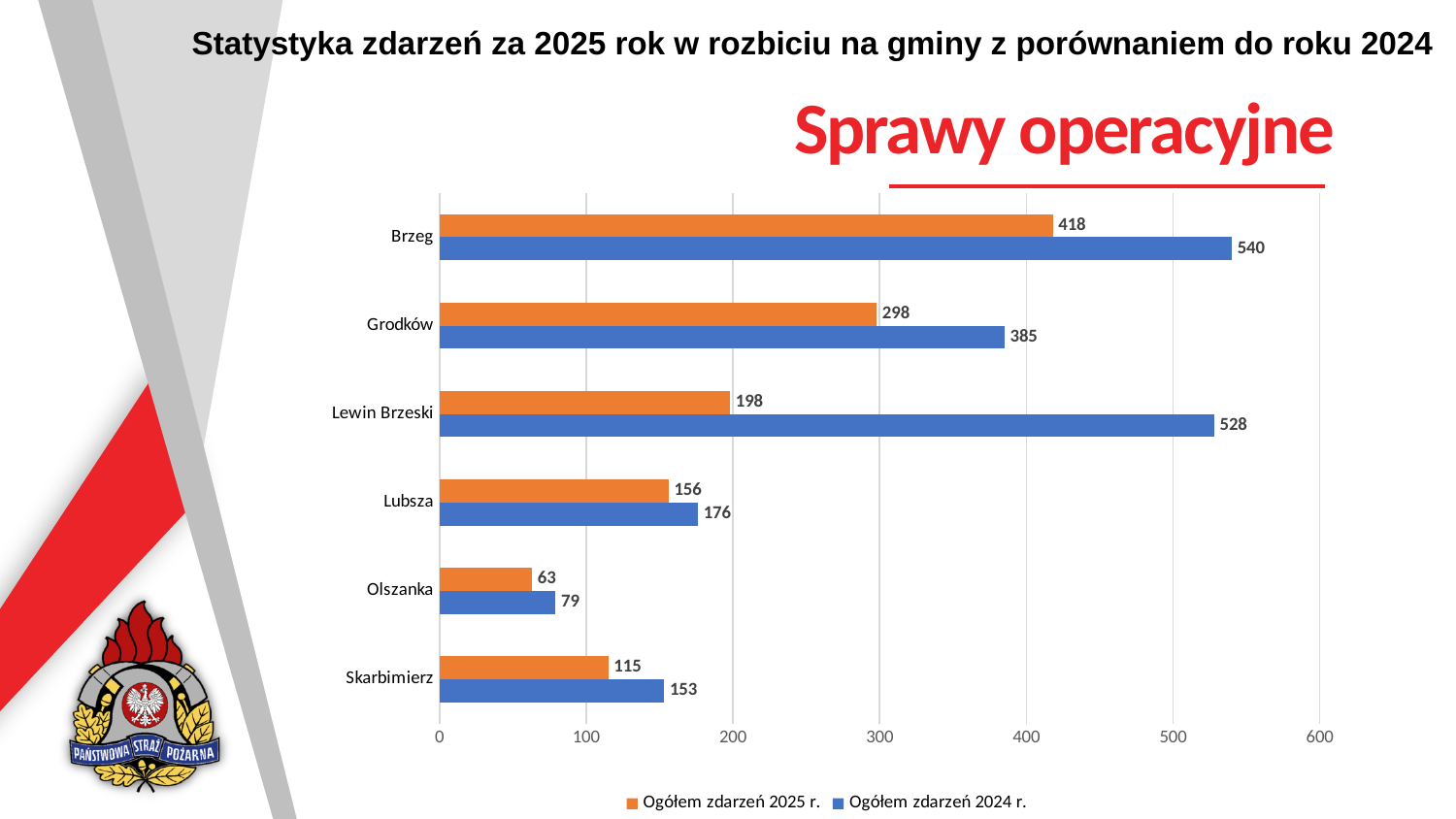
How many series does the legend list? 2 What is the value for Brzeg in the 'Ogółem zdarzeń 2024 r.' series? 540 Which is larger: the 2025 value for Skarbimierz or the 2025 value for Lubsza? Lubsza What is the difference between the 2024 and 2025 values for Grodków? 87 How many gminy are shown on the chart? 6 Which gmina has the lowest value in the 'Ogółem zdarzeń 2024 r.' series? Olszanka What is the difference between the 2024 and 2025 values for Lewin Brzeski? 330 Which gmina has the highest value in the 'Ogółem zdarzeń 2025 r.' series? Brzeg What is the value for Lewin Brzeski in the 'Ogółem zdarzeń 2025 r.' series? 198 What is the value for Olszanka in the 'Ogółem zdarzeń 2024 r.' series? 79 What kind of chart is shown on the slide? bar chart Is the 2024 value for Grodków greater or less than 400? less